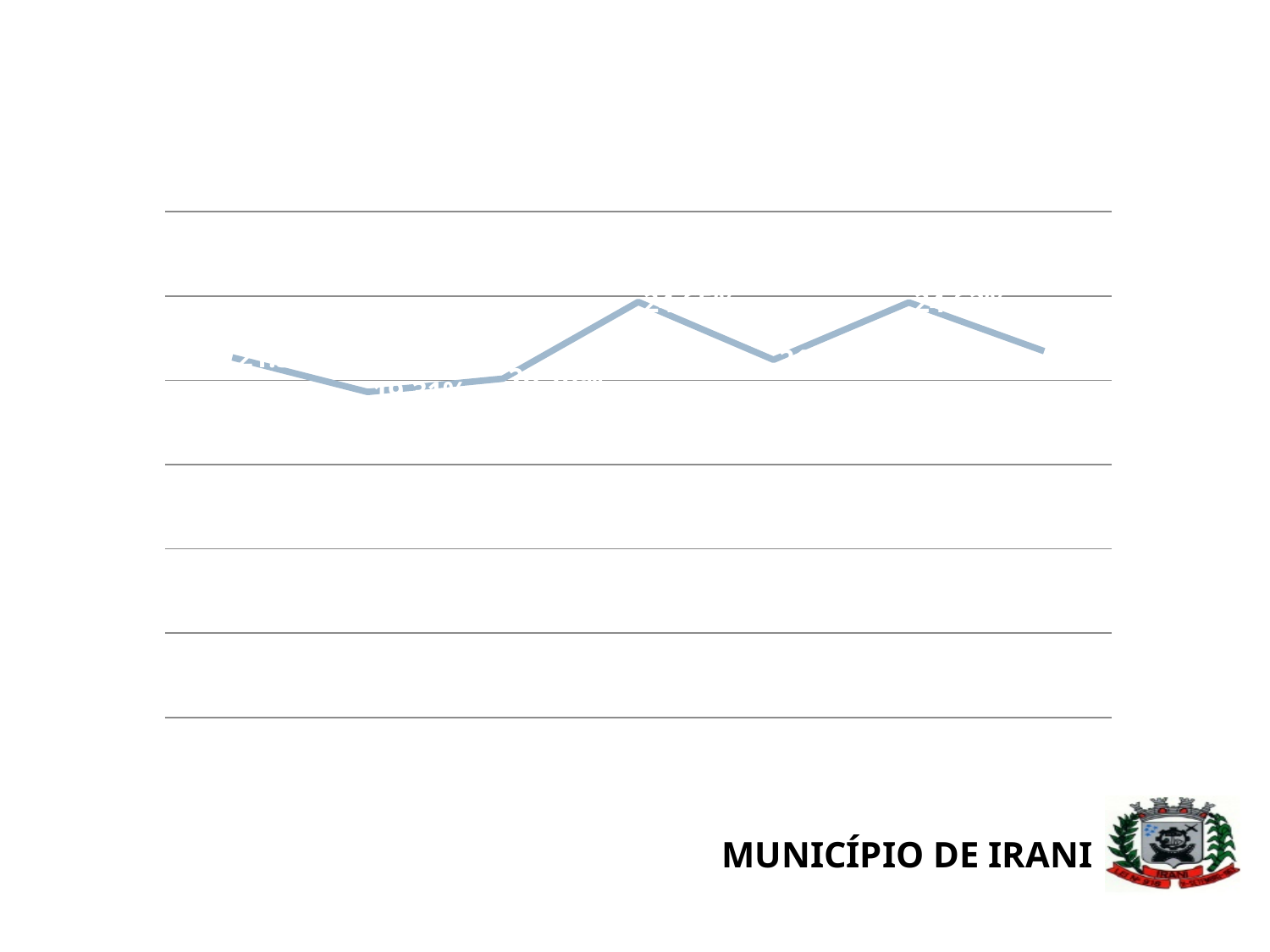
Does the line rise or fall between the third and fourth data points from the left? rise How many data points are plotted on the line in the chart? 7 Does the line rise or fall between the sixth and seventh data points from the left? fall What colour is the plotted line in the chart? light blue Counting from the left, is the fourth data point higher or lower than the fifth data point? higher What kind of chart is shown on the slide? line chart Does the line rise or fall between the first and second data points from the left? fall How many lines (series) are plotted in the chart? 1 Counting from the left, which data point on the line is the lowest? the second point